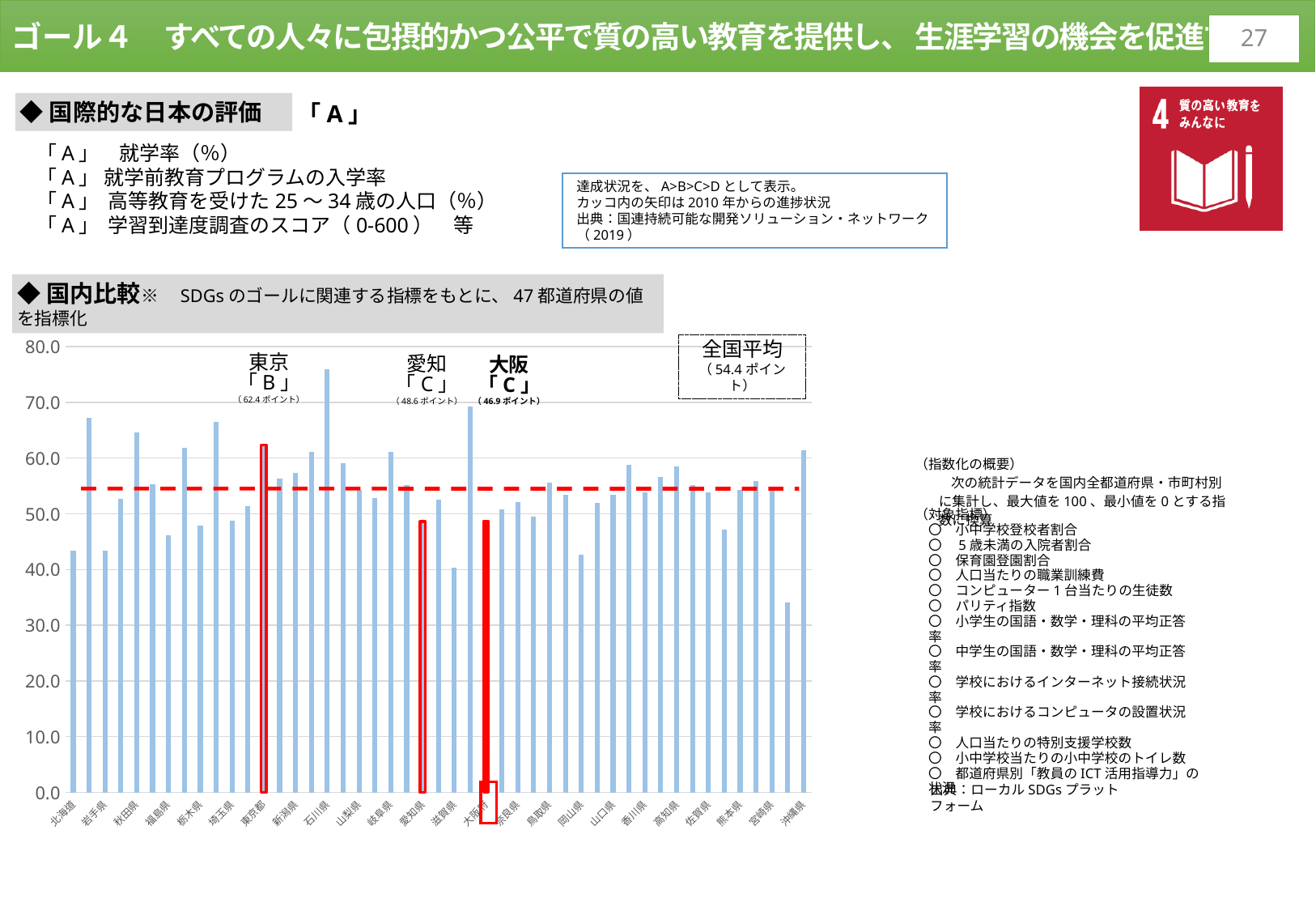
Is the value for 大阪 greater or less than the 全国平均 of 54.4? less What kind of chart is used for the 国内比較 section? bar chart Which has the larger value on the chart, 東京 or 愛知? 東京 Is the value for 北海道 greater or less than 40.0? greater What is the difference between the values for 東京 and 大阪 on the chart? 15.5 ポイント What is the value shown for 大阪 (Osaka) in the 国内比較 bar chart? 46.9 ポイント What does the red dashed horizontal line on the chart represent? 全国平均 (54.4 ポイント) How many prefectures are compared in the 国内比較 chart? 47 What is the 全国平均 (national average) value shown on the chart? 54.4 ポイント What is the value shown for 東京 (Tokyo) in the 国内比較 bar chart? 62.4 ポイント What is the value shown for 愛知 (Aichi) in the 国内比較 bar chart? 48.6 ポイント What is the difference between the values for 愛知 and 大阪 on the chart? 1.7 ポイント